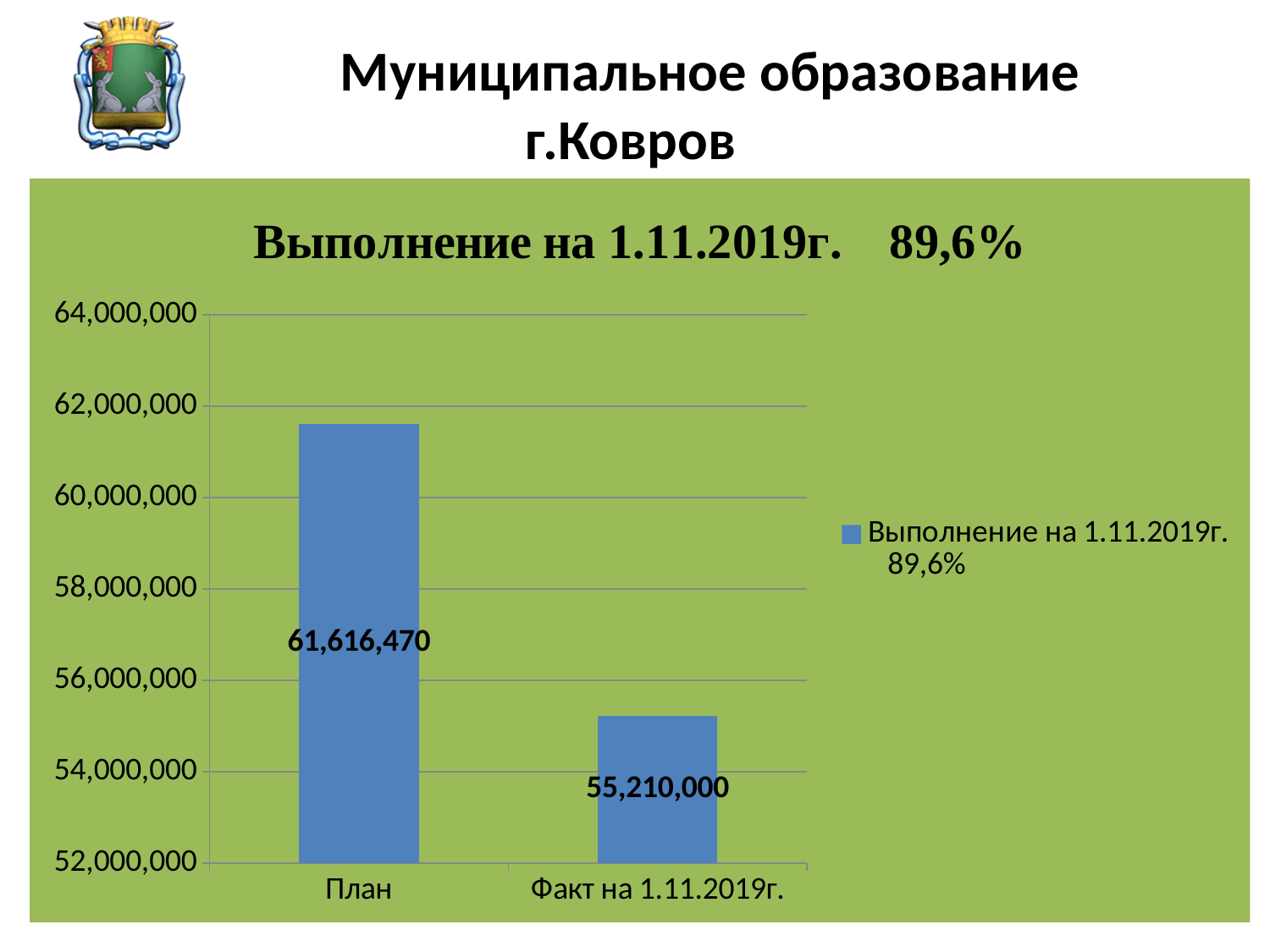
How many categories are shown on the x axis? 2 What is the difference between the values for План and Факт на 1.11.2019г.? 6,406,470 What is the title of the chart? Выполнение на 1.11.2019г. 89,6% Is the value for Факт на 1.11.2019г. greater or less than 56,000,000? less Which is larger, the value for План or the value for Факт на 1.11.2019г.? План What is the value for План? 61,616,470 What is the value for Факт на 1.11.2019г.? 55,210,000 How many series does the legend list? 1 Which category has the highest value? План Is the value for План greater or less than 60,000,000? greater What kind of chart is shown? bar chart Which category has the lowest value? Факт на 1.11.2019г.